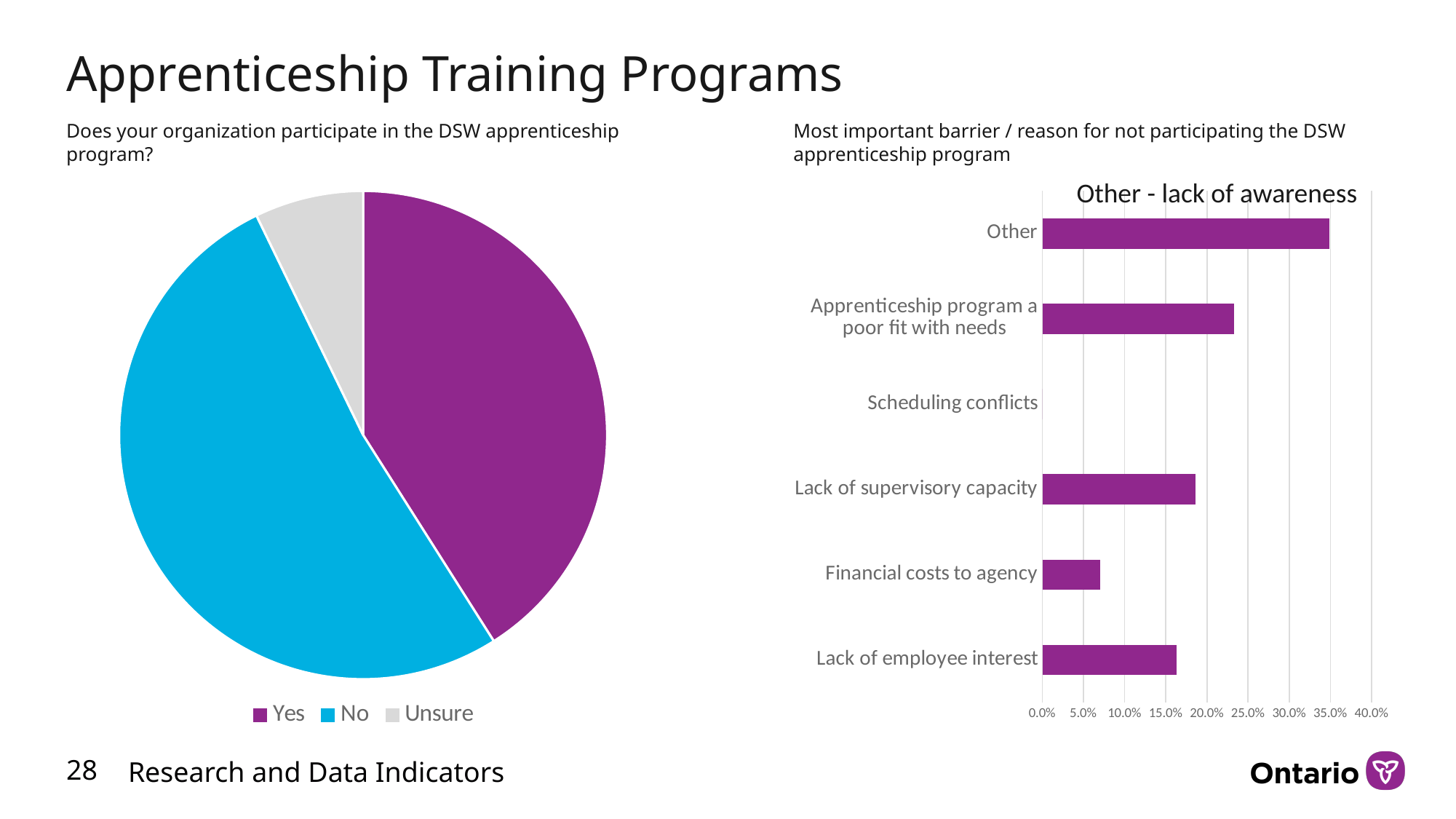
In the pie chart on the left, which category has the smallest slice? Unsure In the bar chart on the right, which is larger: Apprenticeship program a poor fit with needs or Lack of supervisory capacity? Apprenticeship program a poor fit with needs In the bar chart on the right, which category has the lowest value? Scheduling conflicts What kind of chart is the chart on the right of the slide? bar chart In the pie chart on the left, how many entries does the legend list? 3 In the bar chart on the right, is the value for Financial costs to agency greater or less than 10.0%? less In the bar chart on the right, what text is shown above the Other bar? Other - lack of awareness What kind of chart is the chart on the left of the slide? pie chart In the bar chart on the right, is the value for Other greater or less than 30.0%? greater In the bar chart on the right, how many categories are listed on the axis? 6 In the pie chart on the left, which slice is larger: Yes or Unsure? Yes In the bar chart on the right, which category has the highest value? Other